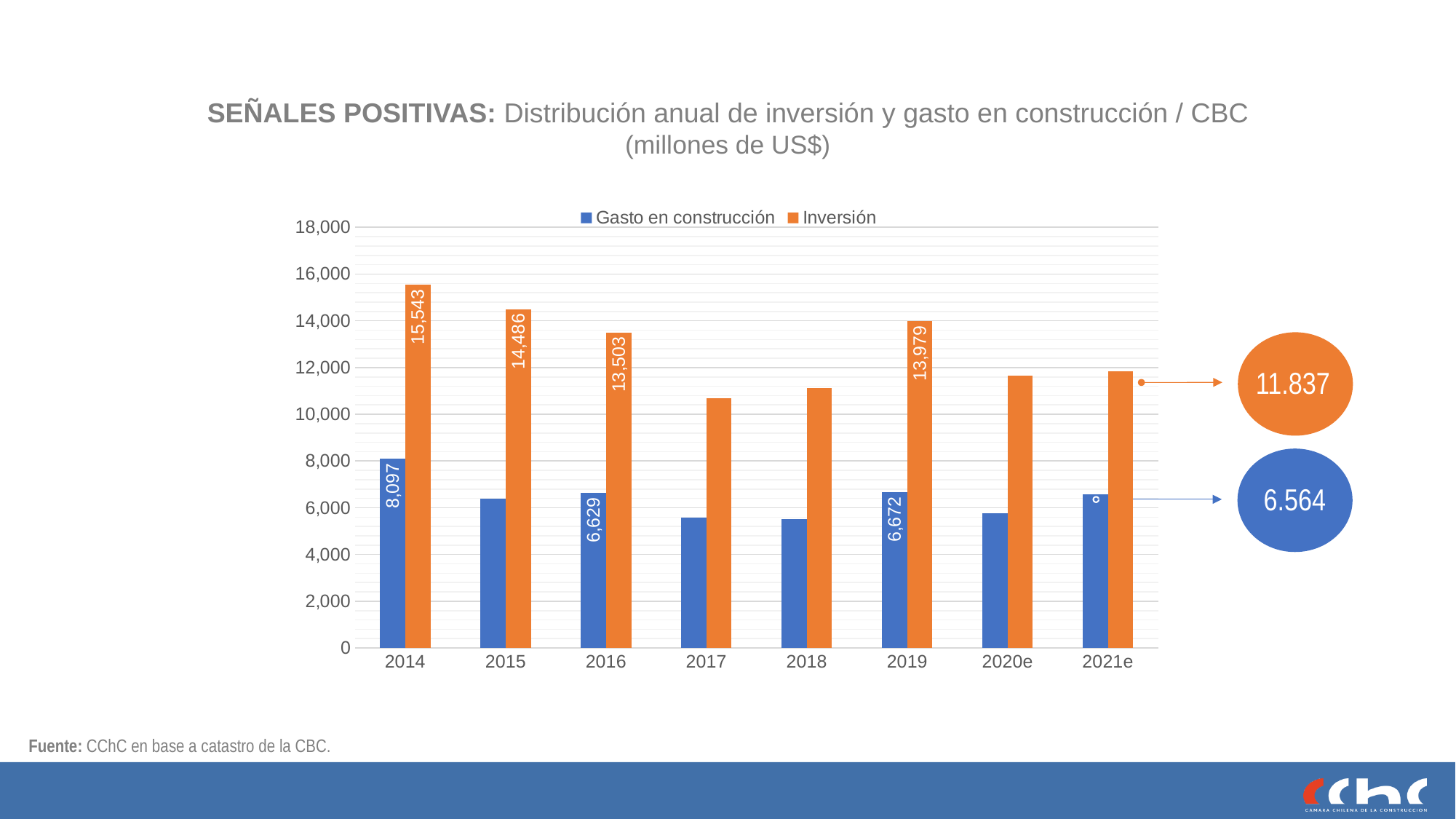
What kind of chart is shown on the slide? bar chart In which year is Inversión highest? 2014 How many series does the legend list? 2 What is the value of Gasto en construcción for 2014? 8,097 What is the value of Inversión for 2014? 15,543 What is the value of Inversión for 2015? 14,486 Which is larger, Gasto en construcción in 2016 or in 2019? 2019 How many years are shown on the x axis? 8 What is the value of Gasto en construcción for 2019? 6,672 Is the value of Inversión for 2017 greater or less than 10,000? greater Does Inversión rise or fall from 2014 to 2016? fall What is the difference between Inversión and Gasto en construcción in 2014? 7,446